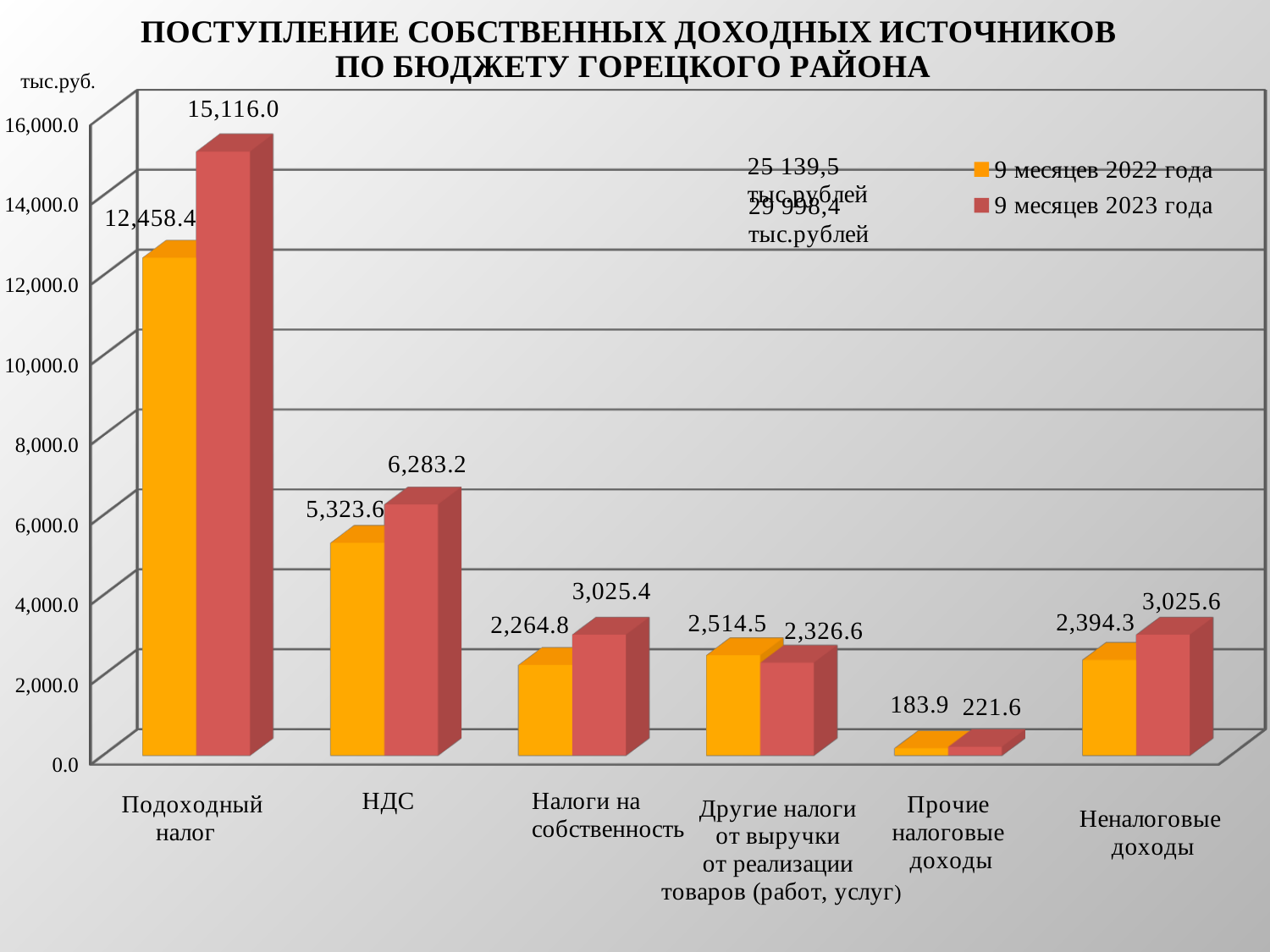
Which category has the lowest value in the 9 месяцев 2023 года series? Прочие налоговые доходы What is the difference between the 9 месяцев 2023 года and 9 месяцев 2022 года values for Подоходный налог? 2,657.6 How many series does the legend list? 2 How many categories are shown on the x axis of the chart? 6 What kind of chart is shown on the slide? bar chart Which category has the highest value in the 9 месяцев 2022 года series? Подоходный налог What is the value for Прочие налоговые доходы in the 9 месяцев 2023 года series? 221.6 What unit is shown at the top of the vertical axis? тыс.руб. Is the value for Неналоговые доходы in the 9 месяцев 2022 года series greater or less than 2,000.0? greater What is the value for Подоходный налог in the 9 месяцев 2023 года series? 15,116.0 What is the value for НДС in the 9 месяцев 2022 года series? 5,323.6 For Другие налоги от выручки от реализации товаров (работ, услуг), which series has the larger value: 9 месяцев 2022 года or 9 месяцев 2023 года? 9 месяцев 2022 года